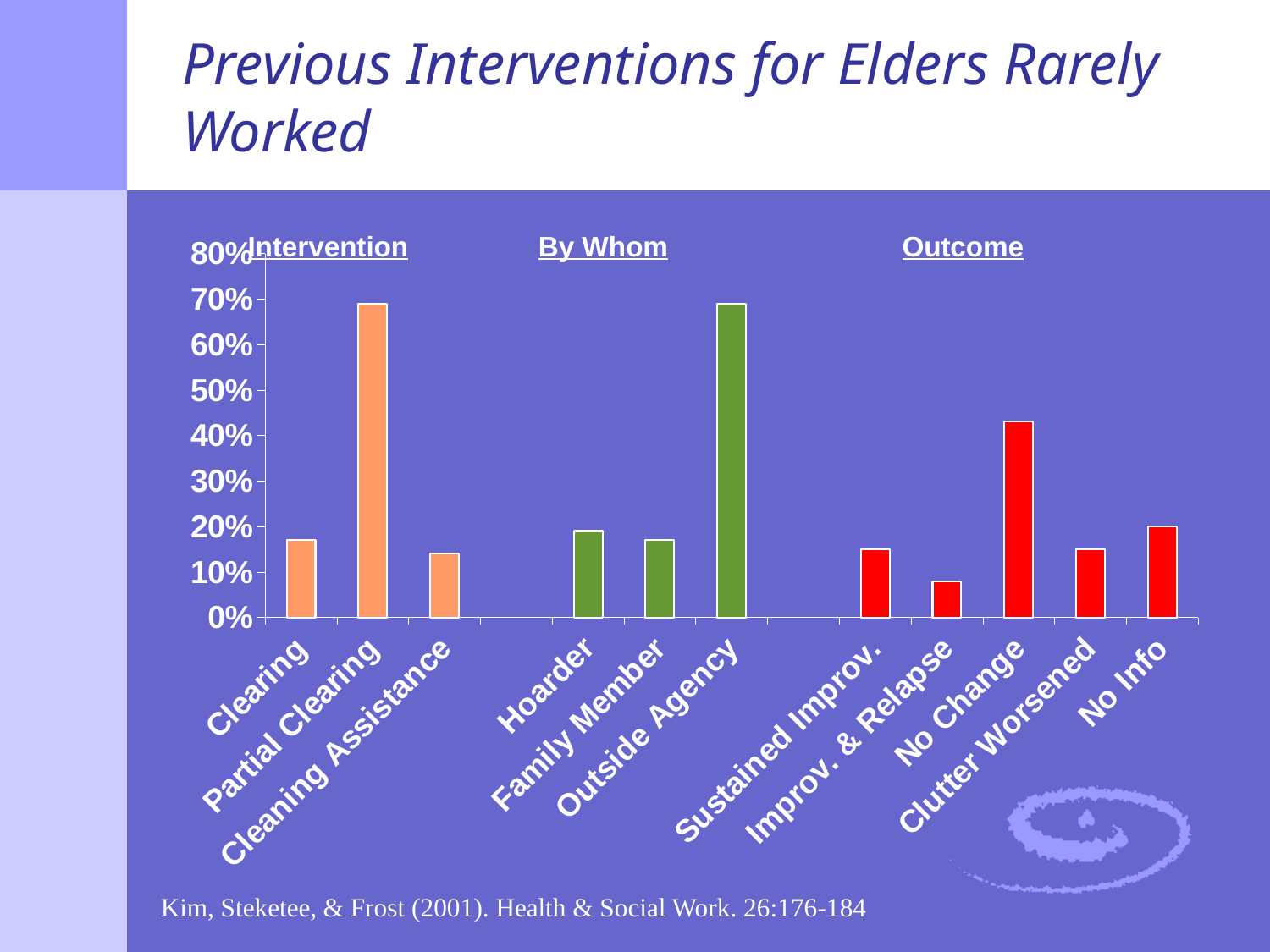
Is the value for Cleaning Assistance greater or less than 20%? less Is the value for Improv. & Relapse greater or less than 10%? less What are the three group headings shown above the bars in the chart? Intervention, By Whom, Outcome Is the value for Partial Clearing greater or less than 60%? greater What kind of chart is shown on the slide? bar chart Which is larger, the value for Partial Clearing or the value for Clearing? Partial Clearing Which is larger, the value for No Change or the value for Clutter Worsened? No Change Which category has the lowest bar in the chart? Improv. & Relapse Which category in the Outcome group has the highest bar? No Change How many categories are plotted along the x axis of the chart? 11